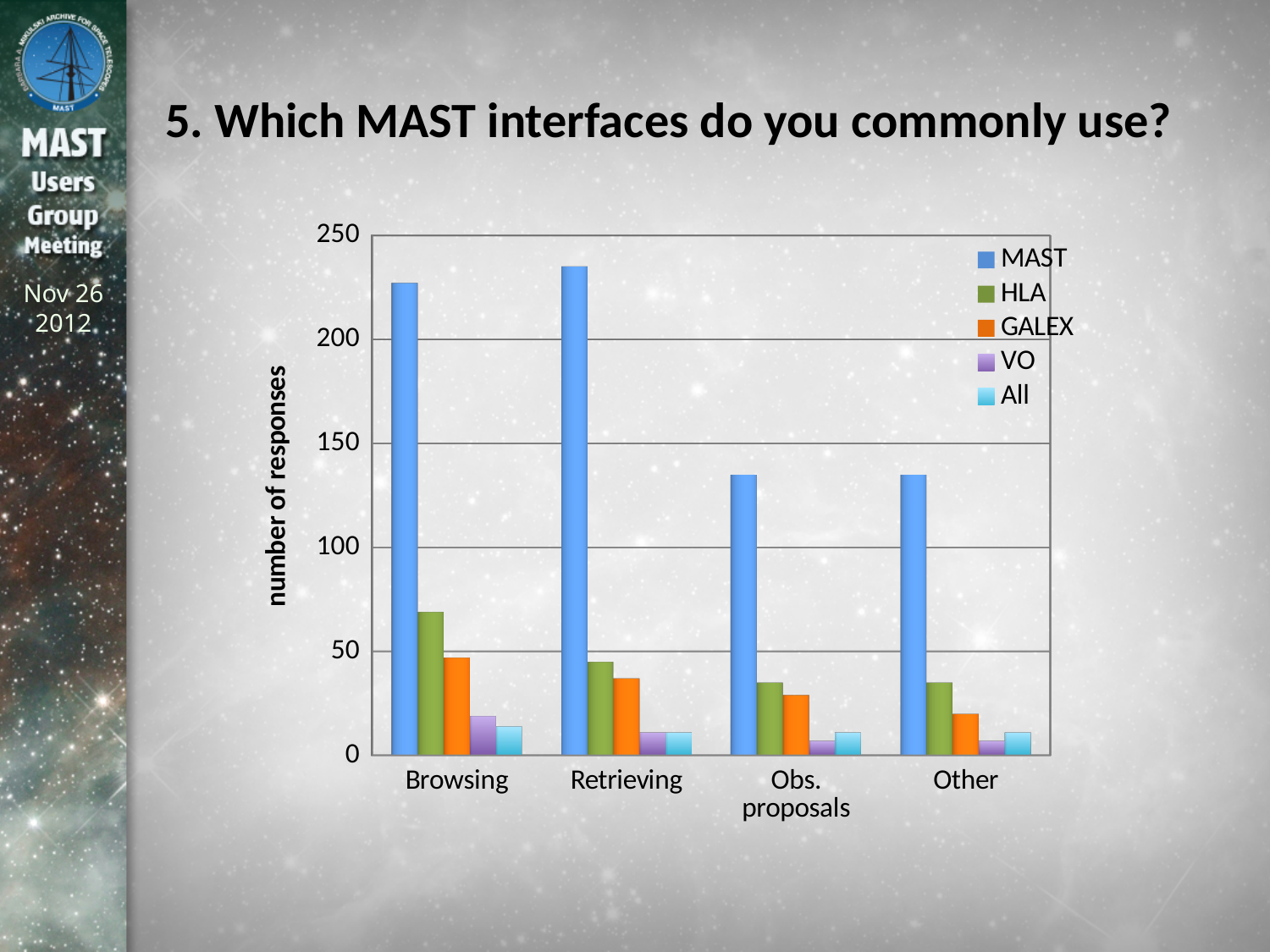
Is the MAST value for Obs. proposals greater or less than 150? less How many series does the legend list? 5 How many categories are shown on the x axis? 4 Is the HLA value for Browsing greater or less than 50? greater What kind of chart is shown on the slide? bar chart Which series is shown in blue in the legend? MAST For Browsing, which is larger: the HLA value or the GALEX value? HLA What is the label of the y axis? number of responses Is the MAST value for Browsing greater or less than 200? greater For which category is the GALEX value lowest? Other For which category is the HLA value highest? Browsing